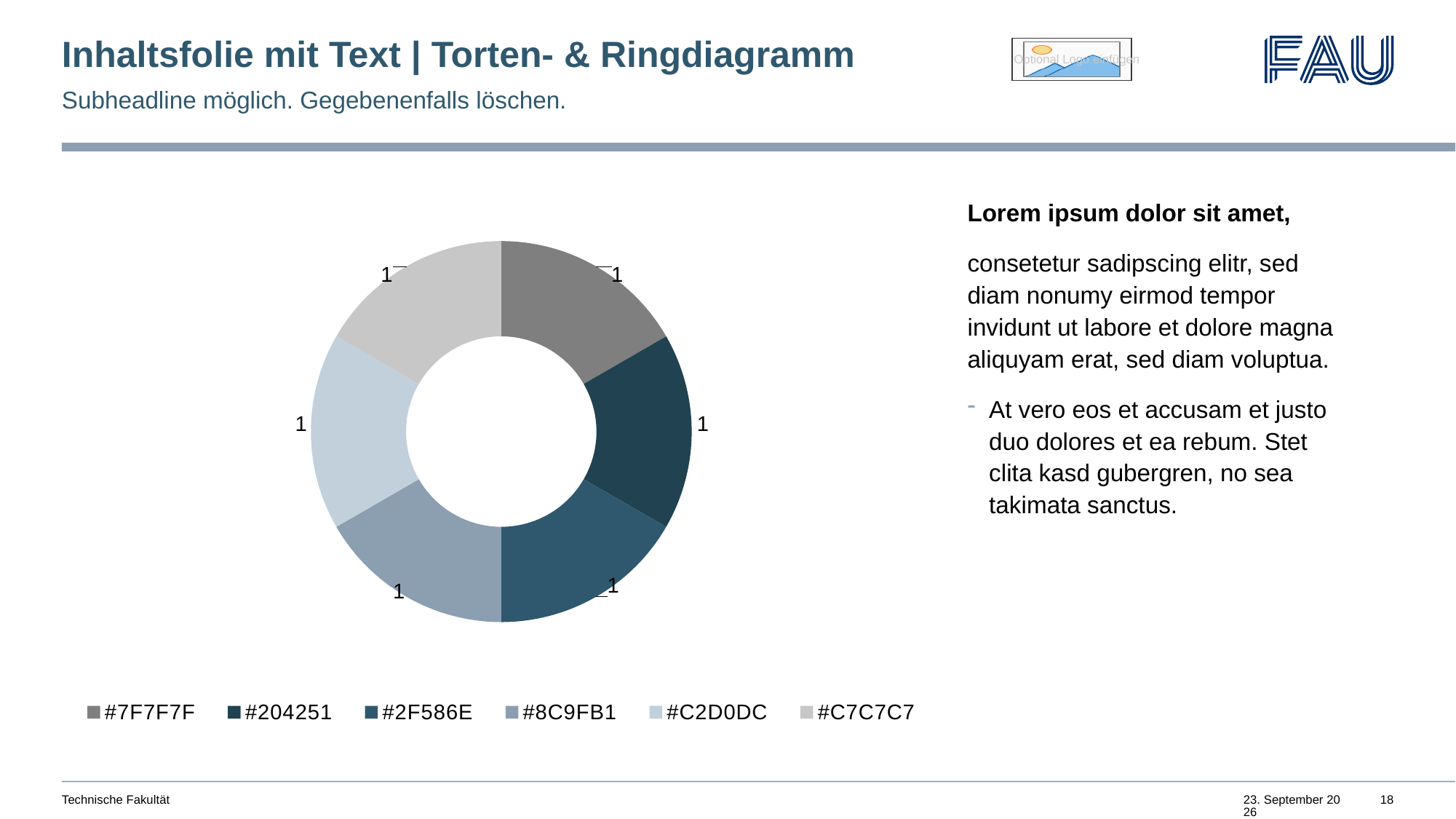
What is the difference between the values of the #2F586E and #8C9FB1 slices? 0 What is the total of all slice values in the doughnut chart? 6 What is the value of the #7F7F7F slice? 1 What kind of chart is shown on the slide? doughnut chart What is the value of the #204251 slice? 1 How many slices does the doughnut chart have? 6 What share of the doughnut does the #C7C7C7 slice represent? 1/6 Which legend entry is listed last? #C7C7C7 What is the value of the #C2D0DC slice? 1 How many entries does the legend list? 6 Which legend entry is listed first? #7F7F7F